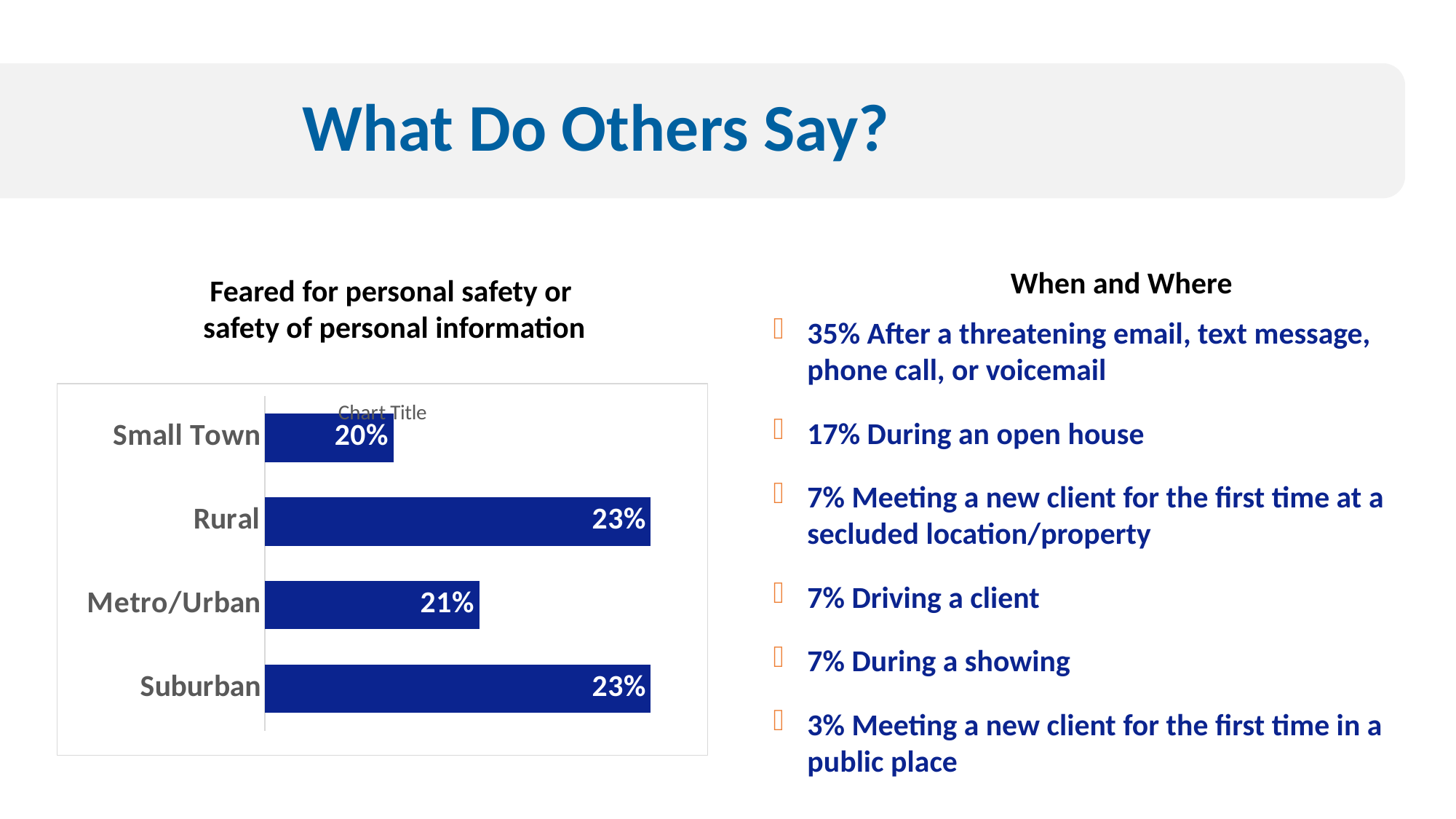
How many categories are shown in the chart? 4 What is the value for Metro/Urban in the chart? 21% What kind of chart is shown on the slide? bar chart Which is larger, the value for Rural or the value for Metro/Urban? Rural What is the difference between the values for Rural and Small Town? 3% What is the value for Suburban in the chart? 23% Which is larger, the value for Suburban or the value for Small Town? Suburban Which category has the lowest value in the chart? Small Town What is the value for Rural in the chart? 23% What is the value for Small Town in the chart? 20% What is the difference between the values for Suburban and Metro/Urban? 2% What is the heading printed above the chart? Feared for personal safety or safety of personal information